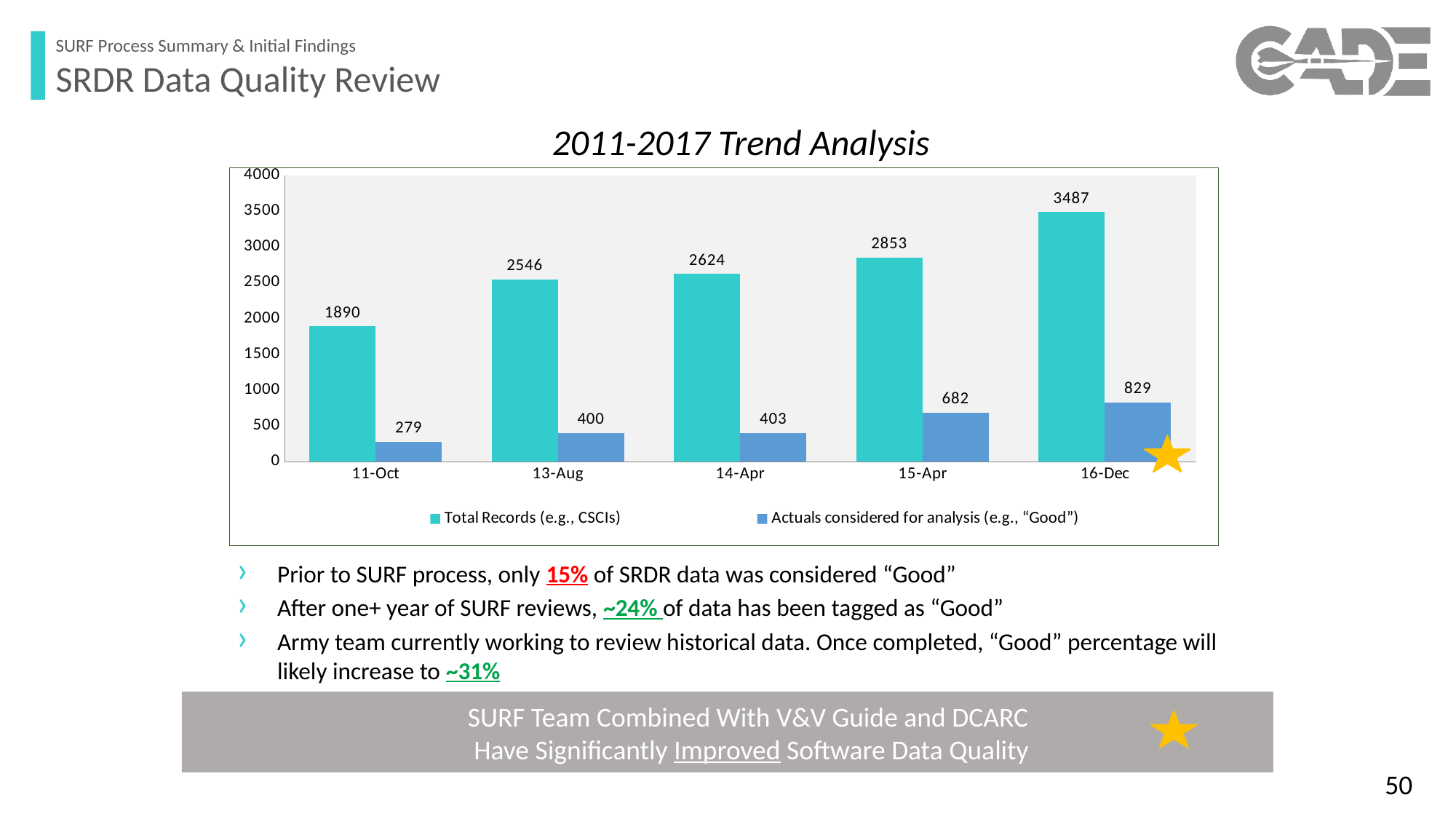
What is the difference between Total Records and Actuals considered for analysis for 15-Apr? 2171 How many series does the legend list? 2 What kind of chart is shown on the slide? Bar chart Is the value of Total Records (e.g., CSCIs) for 13-Aug greater or less than 2500? greater What is the value of Total Records (e.g., CSCIs) for 16-Dec? 3487 How many categories are shown on the x axis? 5 Which is larger: Actuals considered for analysis for 13-Aug or for 14-Apr? 14-Apr What is the value of Total Records (e.g., CSCIs) for 14-Apr? 2624 Do the Total Records (e.g., CSCIs) values rise or fall from 11-Oct to 16-Dec? Rise What is the value of Actuals considered for analysis (e.g., "Good") for 11-Oct? 279 Which category has the lowest value for Total Records (e.g., CSCIs)? 11-Oct Which category has the highest value for Actuals considered for analysis (e.g., "Good")? 16-Dec